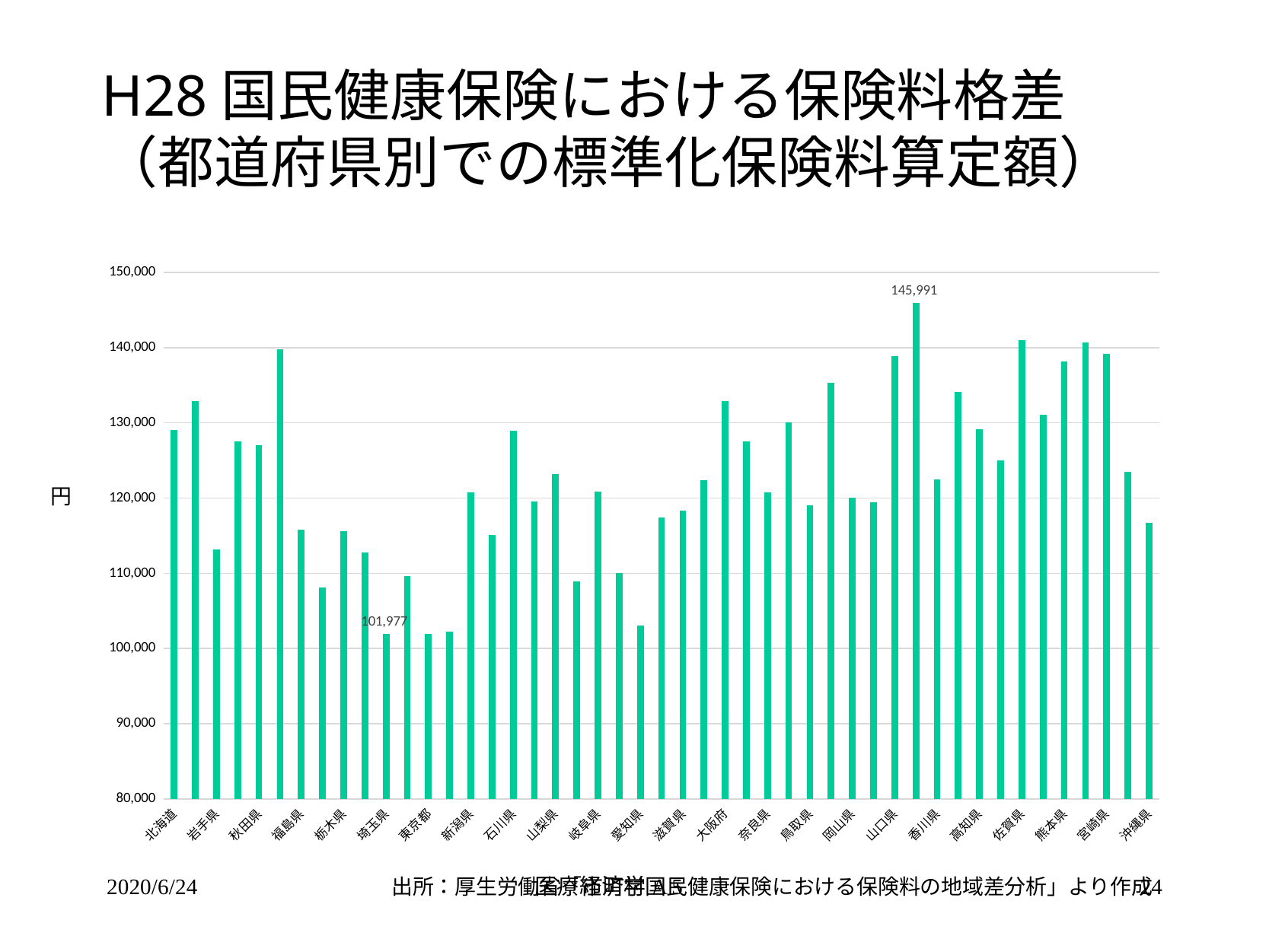
Is the value for 大阪府 greater or less than 130,000? greater What is the highest value shown in the chart? 145,991 Is the value for 福島県 greater or less than 130,000? less What is the lowest value shown in the chart? 101,977 What unit is shown on the vertical axis of the chart? 円 Which has the larger value, 北海道 or 岩手県? 北海道 Is the value for 東京都 greater or less than 110,000? less What kind of chart is shown on the slide? bar chart What is the difference between the highest labelled value (145,991) and the lowest labelled value (101,977)? 44,014